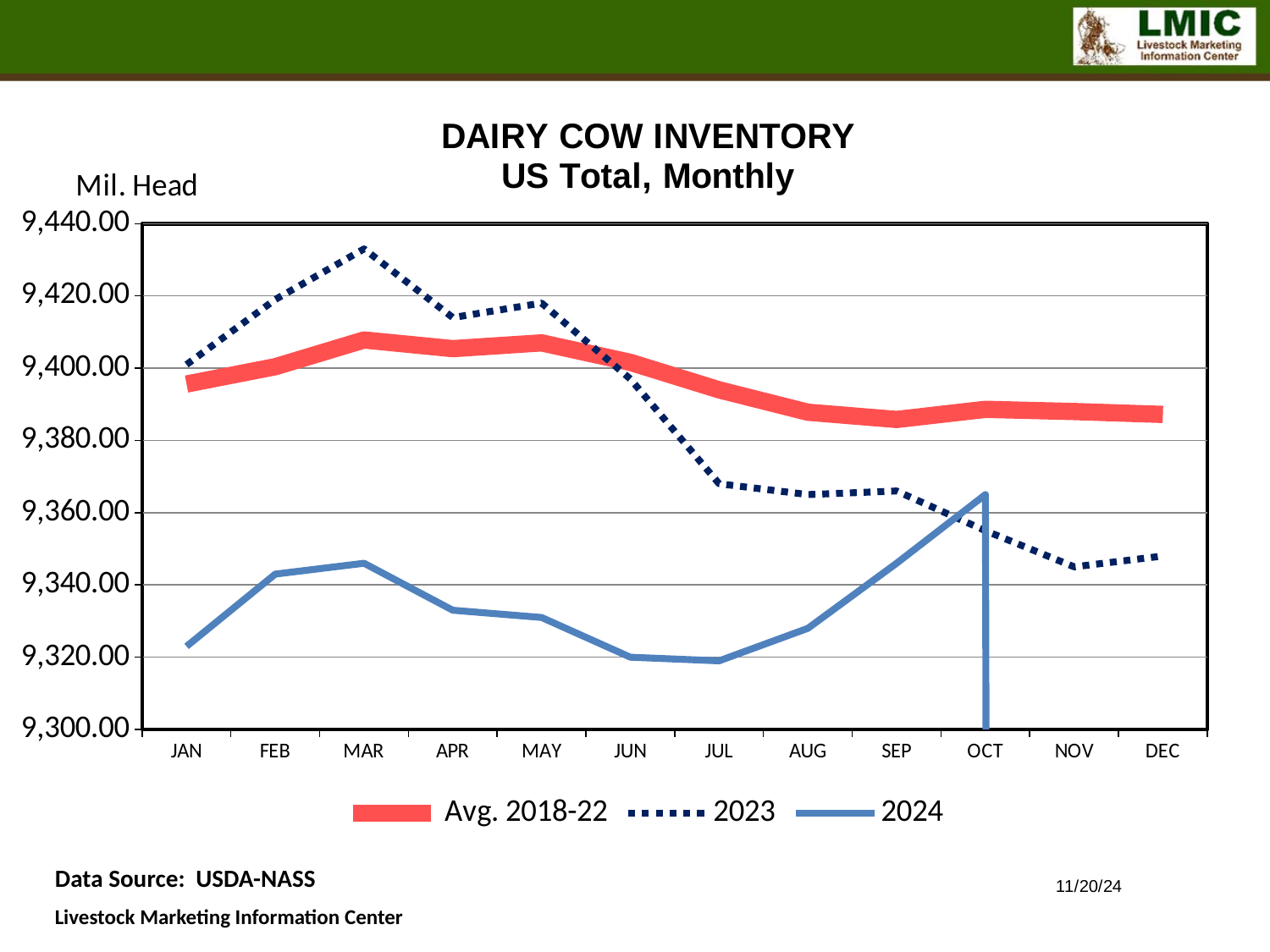
In JAN, which series has the larger value, 2023 or 2024? 2023 In which month does the 2023 series reach its highest value? MAR In JUL, which series has the larger value, Avg. 2018-22 or 2023? Avg. 2018-22 In which month does the 2024 series reach its highest value? OCT Is the 2024 value for JAN greater or less than 9,340.00? less What kind of chart is shown on the slide? line chart Is the 2023 value for AUG greater or less than 9,380.00? less How many months are shown along the x axis? 12 How many series does the legend list? 3 Does the 2023 series rise or fall from MAY to JUL? fall Is the 2023 value for MAR greater or less than 9,420.00? greater In which month does the 2024 series reach its lowest value? JUL